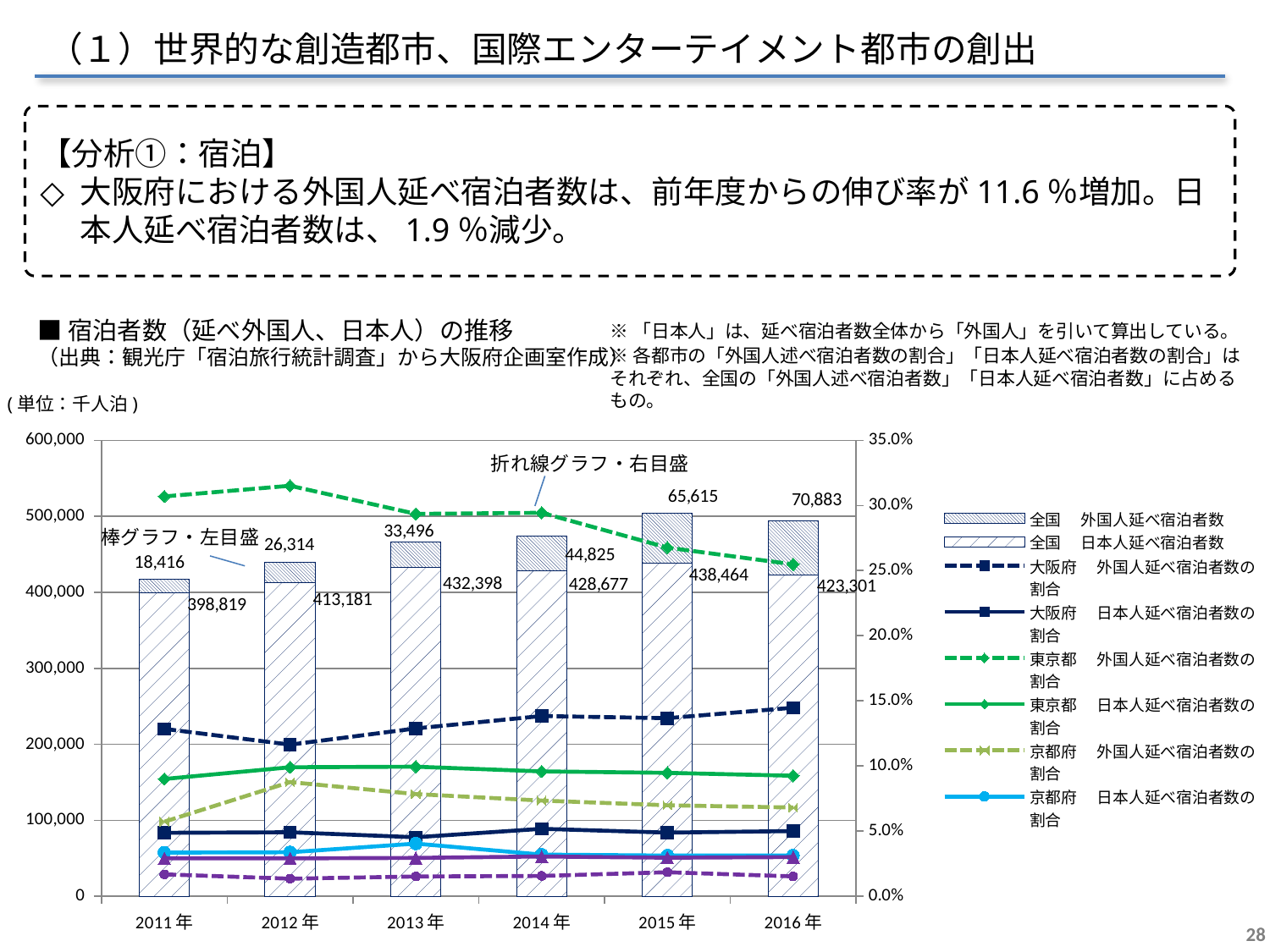
Which is larger, 全国 日本人延べ宿泊者数 in 2014年 or in 2015年? 2015年 Does 全国 外国人延べ宿泊者数 rise or fall from 2011年 to 2016年? rise In which year is 全国 外国人延べ宿泊者数 the highest? 2016年 According to the annotation, which axis do the line graphs use? 右目盛 Is the value for 大阪府 外国人延べ宿泊者数の割合 in 2016年 greater or less than 10.0%? greater How many years are shown on the x axis? 6 What is the total of the stacked bar for 2016年 (外国人 plus 日本人)? 494,184 What is the difference between 全国 外国人延べ宿泊者数 in 2016年 and 2015年? 5,268 What is the value of 全国 日本人延べ宿泊者数 for 2013年? 432,398 How many series does the legend list? 8 In which year is 全国 日本人延べ宿泊者数 the lowest? 2011年 What is the value of 全国 外国人延べ宿泊者数 for 2016年? 70,883